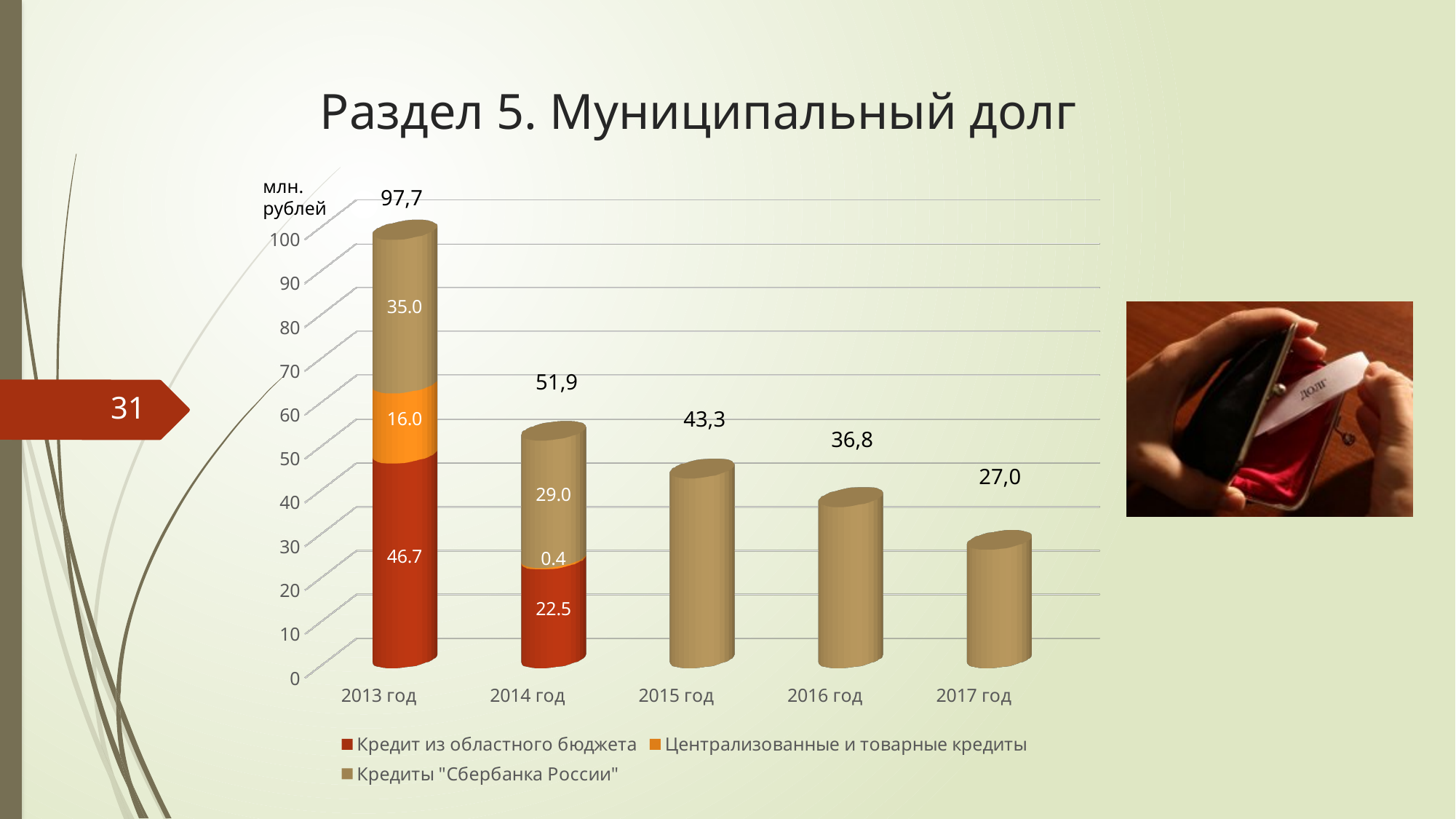
Which year has the lowest total municipal debt? 2017 год Which year has the highest total municipal debt? 2013 год What is the total municipal debt shown for 2013 год? 97,7 Which is larger in 2013 год: Кредит из областного бюджета or Кредиты "Сбербанка России"? Кредит из областного бюджета Do the total debt values rise or fall from 2013 год to 2017 год? Fall What is the value of Кредит из областного бюджета for 2014 год? 22.5 What is the difference between the total debt in 2013 год and 2014 год? 45,8 What is the value of Централизованные и товарные кредиты for 2014 год? 0.4 What is the value of Кредиты "Сбербанка России" for 2013 год? 35.0 How many years are shown on the x axis? 5 How many series does the legend list? 3 What kind of chart is shown on the slide? Stacked bar chart